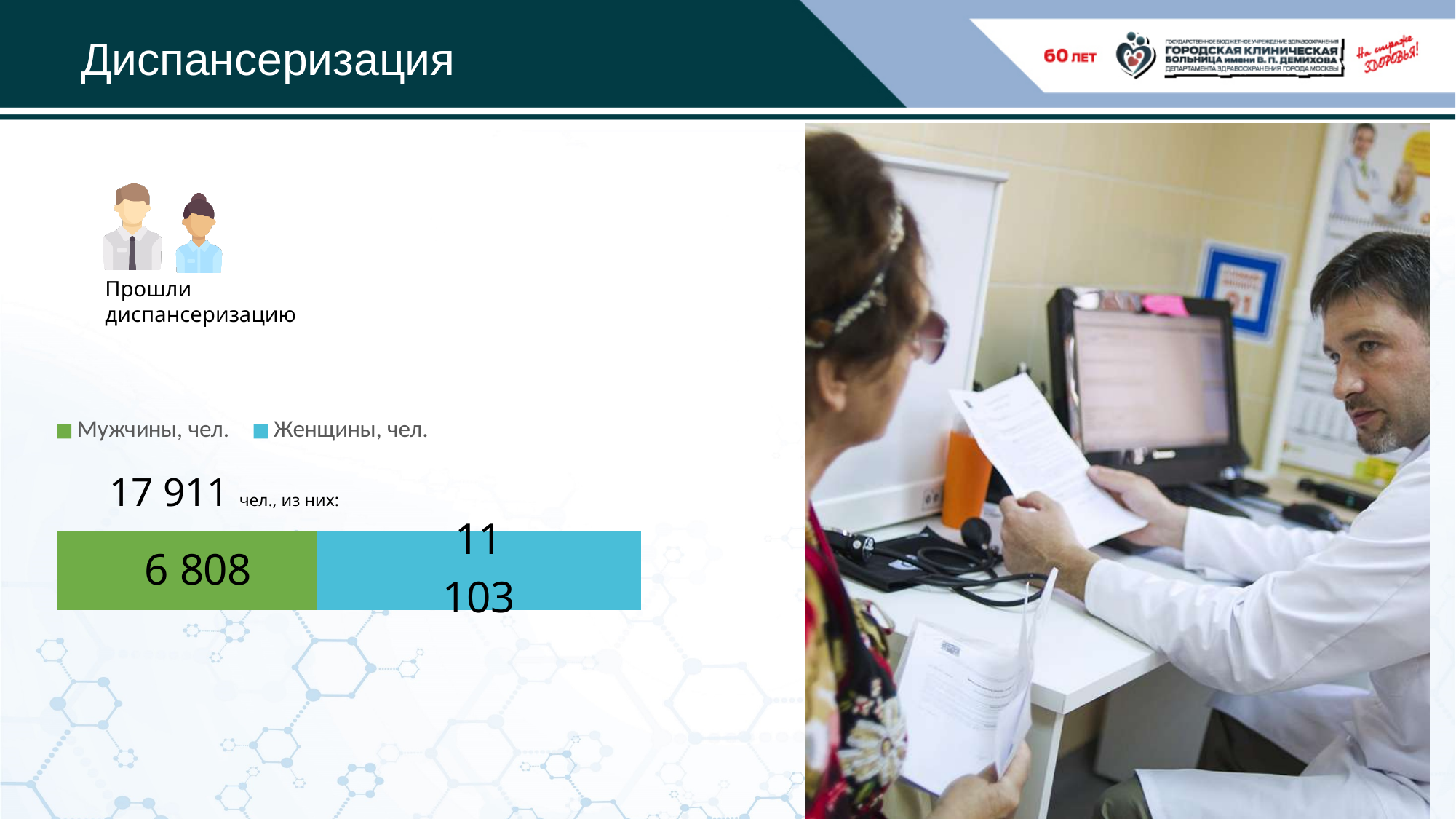
Which series has the smallest value in the chart? Мужчины, чел. What is the value for Женщины, чел. in the chart? 11 103 Which series has the larger value, Мужчины or Женщины? Женщины What colour is the Мужчины, чел. segment of the bar? green What is the difference between the values for Женщины and Мужчины? 4 295 What is the total of the stacked bar (Мужчины plus Женщины)? 17 911 How many segments make up the stacked bar? 2 Which series has the largest value in the chart? Женщины, чел. What kind of chart is shown on the slide? stacked bar chart What is the value for Мужчины, чел. in the chart? 6 808 What colour is the Женщины, чел. segment of the bar? blue How many series does the chart legend list? 2